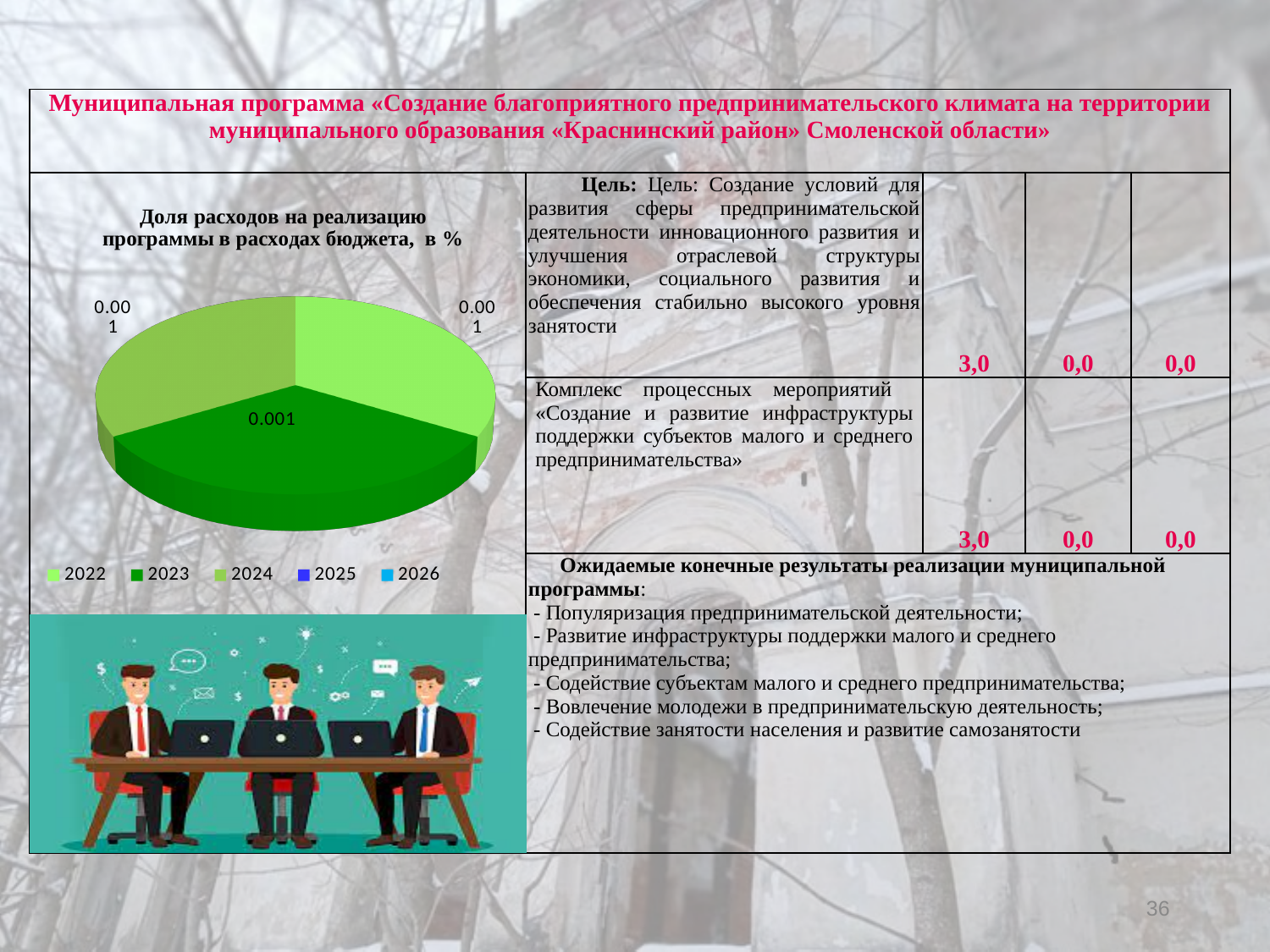
What value is printed on the dark green (2023) slice of the pie chart? 0.001 How many entries does the legend of the pie chart list? 5 Which years are listed in the legend of the pie chart? 2022, 2023, 2024, 2025, 2026 What kind of chart is shown on the slide? pie chart What is the title of the pie chart? Доля расходов на реализацию программы в расходах бюджета, в % What is the first year listed in the legend of the pie chart? 2022 How many slices are visible in the pie chart? 3